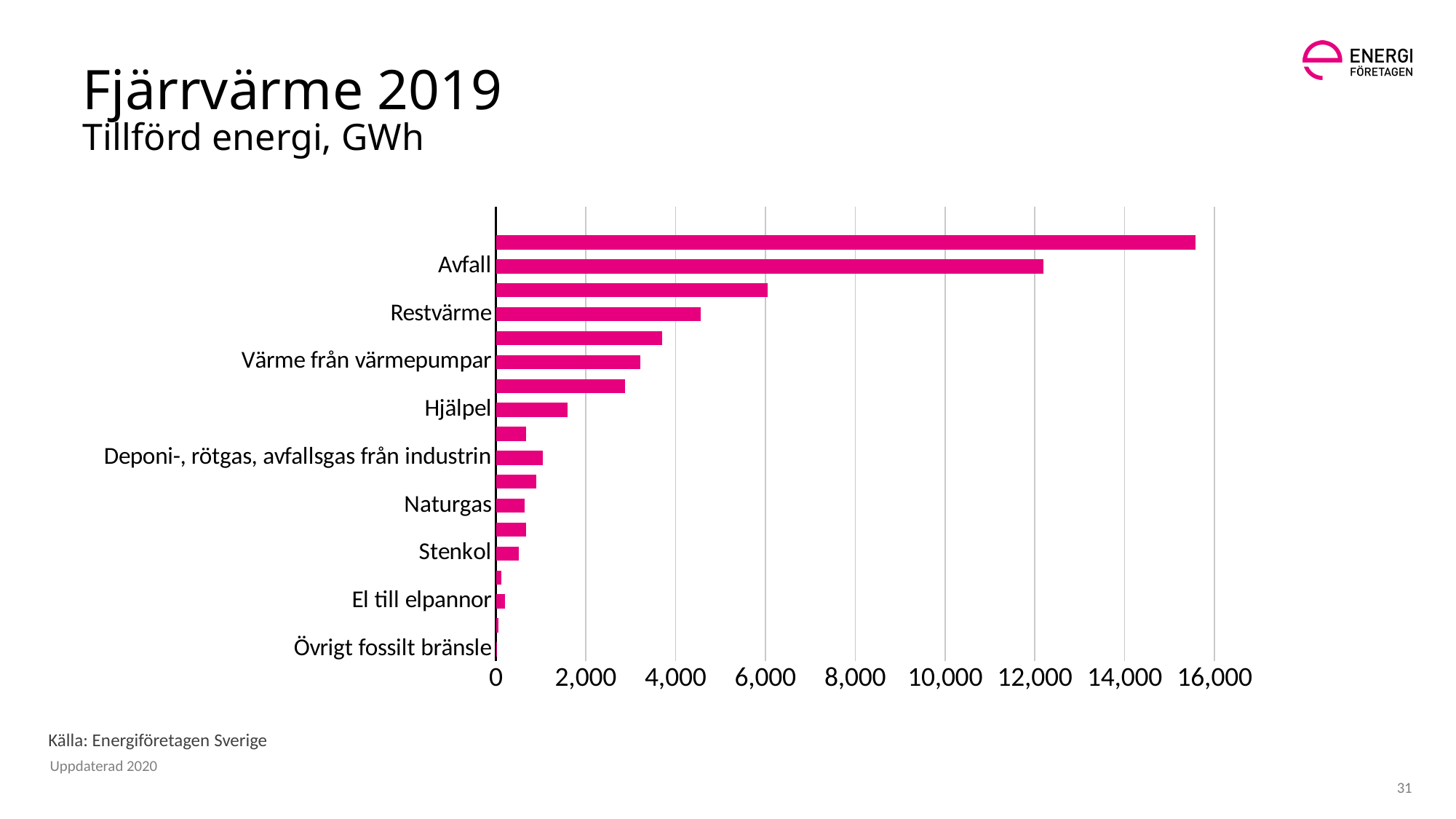
What is the title of the slide containing the chart? Fjärrvärme 2019 Which has the larger value, Avfall or Restvärme? Avfall Which has the larger value, Hjälpel or El till elpannor? Hjälpel Is the value for Restvärme greater or less than 4,000? greater Is the value for Naturgas greater or less than 2,000? less Is the value for Stenkol greater or less than 2,000? less What kind of chart is shown on the slide? bar chart What unit is the supplied energy measured in, according to the chart subtitle? GWh Which has the larger value, Restvärme or Hjälpel? Restvärme